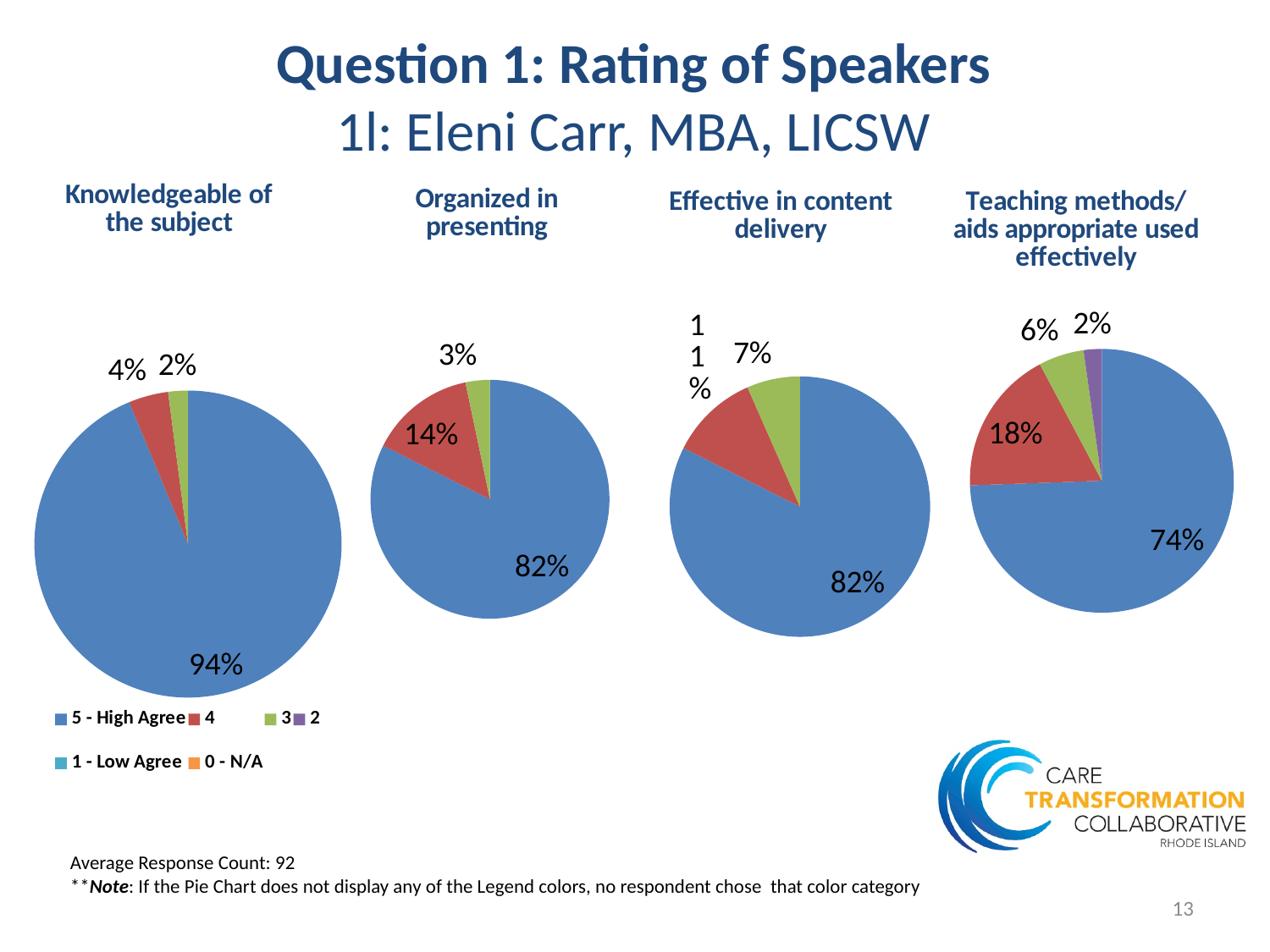
How many pie charts are shown on the slide? 4 In the 'Teaching methods/aids appropriate used effectively' pie chart, what share of respondents chose '5 - High Agree'? 74% What is the difference between the '5 - High Agree' share in the 'Knowledgeable of the subject' chart and in the 'Organized in presenting' chart? 12% In the 'Teaching methods/aids appropriate used effectively' pie chart, what percentage is shown for the '2' rating? 2% Which of the four pie charts has the largest '5 - High Agree' slice? Knowledgeable of the subject In the 'Effective in content delivery' pie chart, what percentage is shown for the '3' rating? 7% Which of the four pie charts has the smallest '5 - High Agree' slice? Teaching methods/aids appropriate used effectively In the 'Organized in presenting' pie chart, what percentage is shown for the '4' rating? 14% Is the '4' rating share larger in the 'Teaching methods/aids appropriate used effectively' chart or in the 'Organized in presenting' chart? Teaching methods/aids appropriate used effectively In the 'Knowledgeable of the subject' pie chart, what share of respondents chose '5 - High Agree'? 94% What type of chart is used to show the speaker ratings on this slide? Pie chart How many categories does the legend list? 6